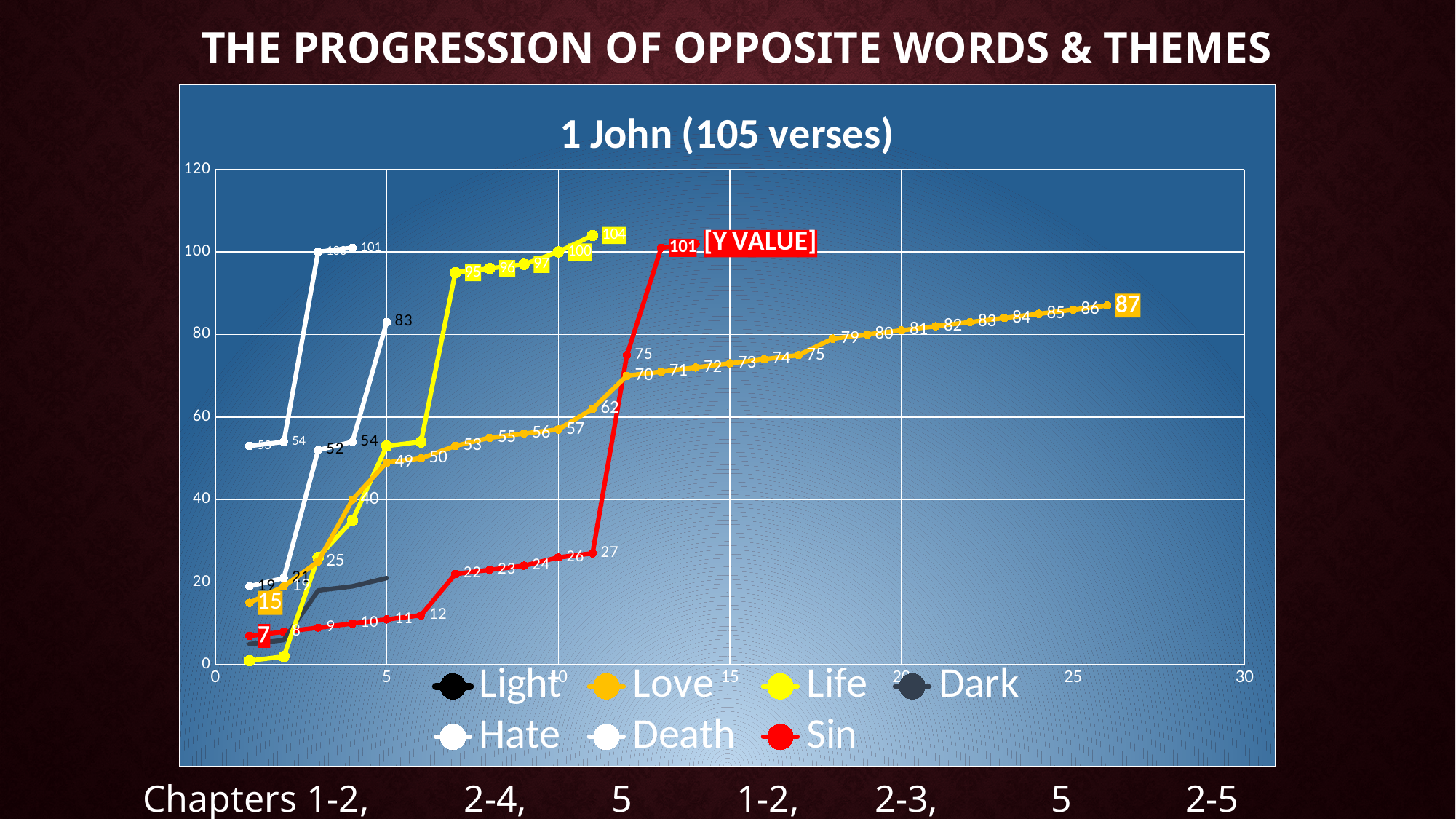
What is the last labelled value of the Sin series? 101 What is the highlighted final value of the Love series? 87 Which is larger, the final value of the Sin series (101) or the final value of the Love series (87)? Sin What is the highlighted first value of the Sin series? 7 What is the highlighted first value of the Love series? 15 What is the difference between the final value of the Love series (87) and its first value (15)? 72 Which series reaches the highest labelled value on the chart? Life What is the title of the chart? 1 John (105 verses) What kind of chart is shown on the slide? line chart How many series does the legend list? 7 What is the highlighted final value of the Life series? 104 Does the Love series rise or fall as it moves along the x axis? rise